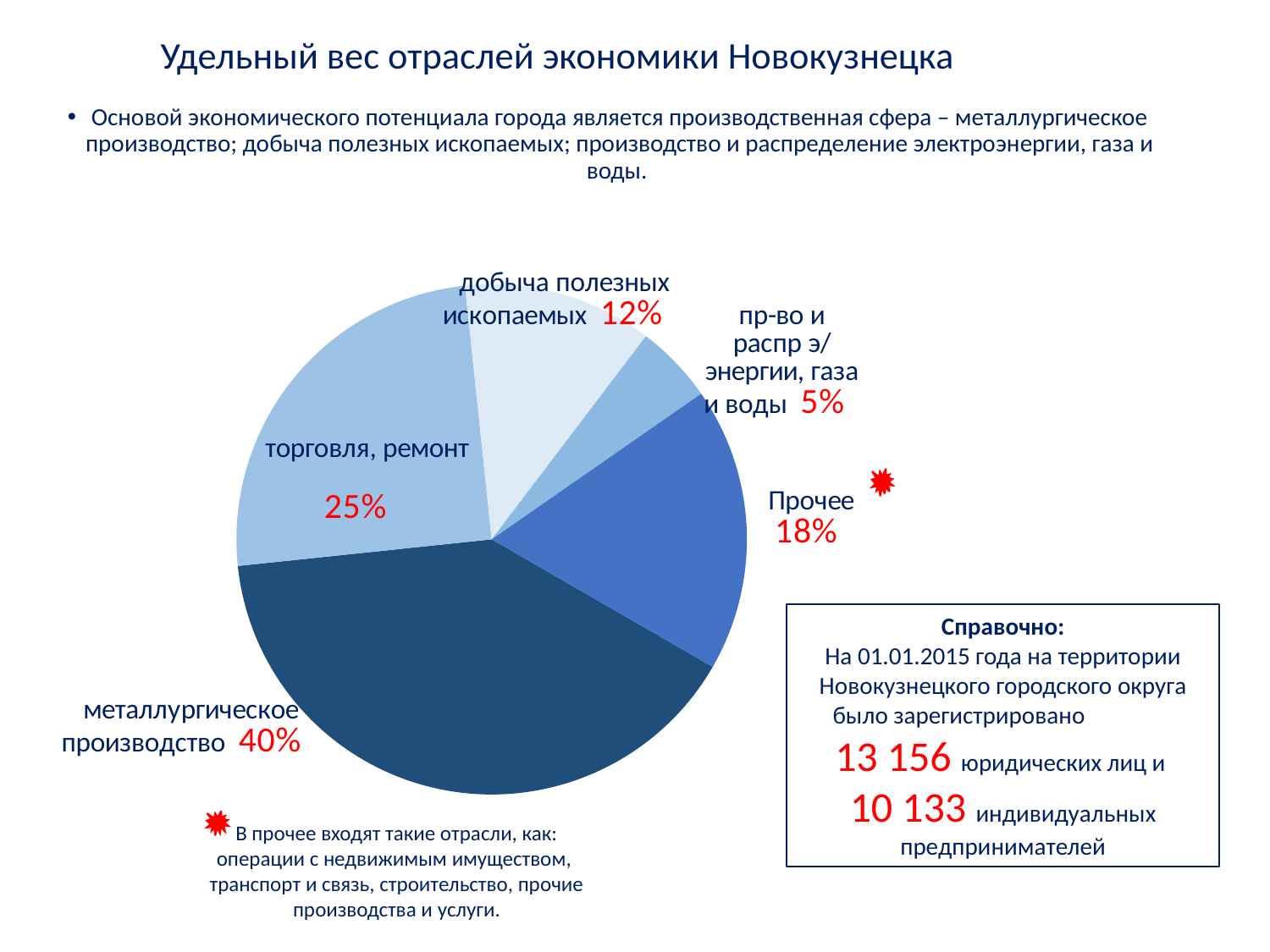
Which sector has the largest share of the pie? металлургическое производство What is the difference in percentage points between металлургическое производство and торговля, ремонт? 15 How many slices does the pie chart have? 5 What share of the pie does металлургическое производство have? 40% Which sector has the smallest share of the pie? пр-во и распр э/энергии, газа и воды Which is larger: the share of Прочее or the share of добыча полезных ископаемых? Прочее What share of the pie does торговля, ремонт have? 25% What share of the pie does пр-во и распр э/энергии, газа и воды have? 5% What kind of chart is shown on the slide? pie chart What is the title of the slide containing the chart? Удельный вес отраслей экономики Новокузнецка What share of the pie does Прочее have? 18% What share of the pie does добыча полезных ископаемых have? 12%